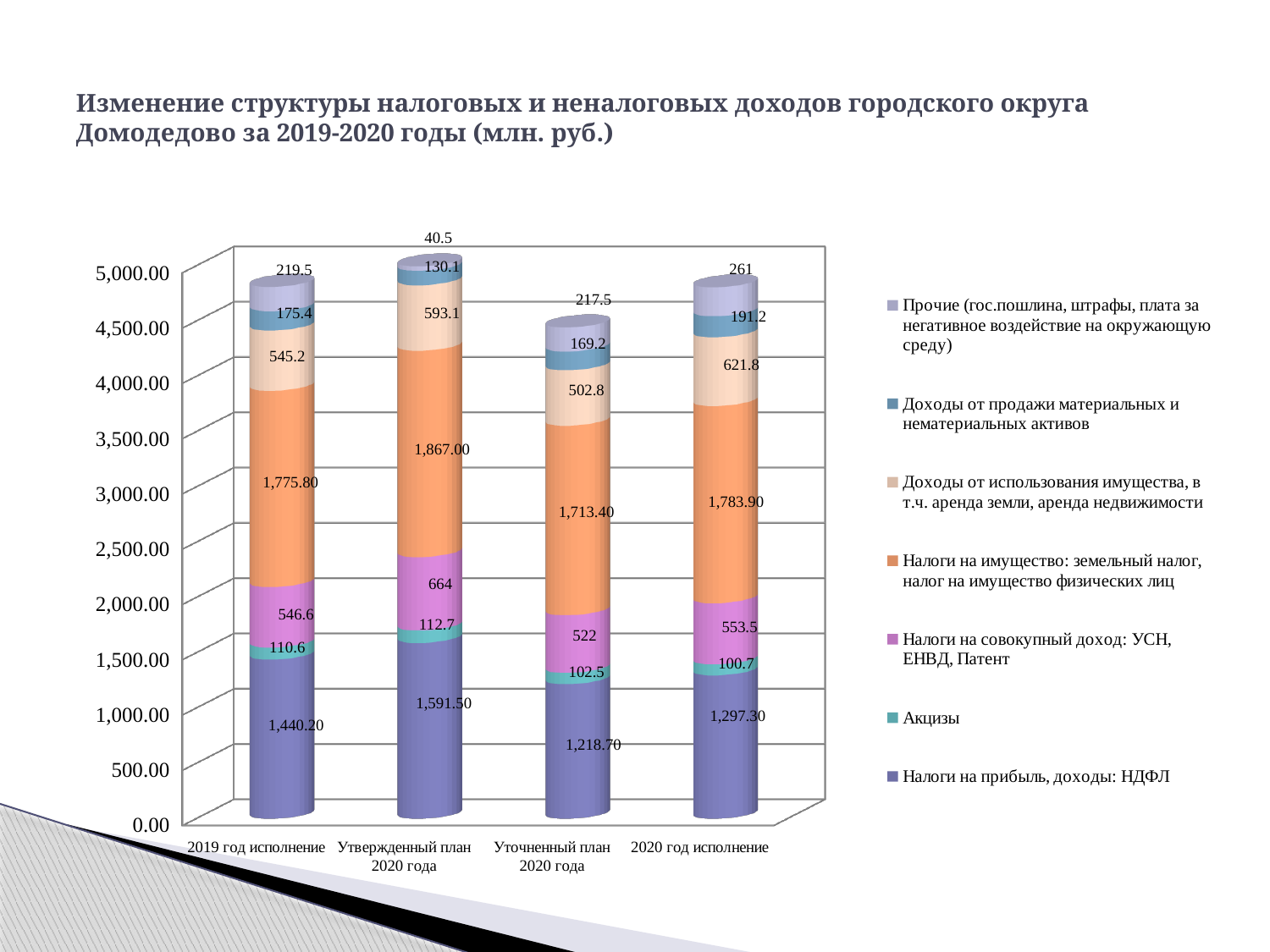
How many categories are shown on the x axis? 4 What is the value of Налоги на прибыль, доходы: НДФЛ for 2019 год исполнение? 1,440.20 How many series does the legend list? 7 What is the value of Доходы от продажи материальных и нематериальных активов for Уточненный план 2020 года? 169.2 What kind of chart is shown on the slide? Stacked bar chart What is the value of Акцизы for 2020 год исполнение? 100.7 Which category has the highest value for Налоги на прибыль, доходы: НДФЛ? Утвержденный план 2020 года What is the difference between Налоги на совокупный доход: УСН, ЕНВД, Патент for Утвержденный план 2020 года and Уточненный план 2020 года? 142 Which is larger for Доходы от использования имущества: Утвержденный план 2020 года or 2020 год исполнение? 2020 год исполнение What is the value of Налоги на имущество: земельный налог, налог на имущество физических лиц for Утвержденный план 2020 года? 1,867.00 What is the total of the stacked bar for 2019 год исполнение? 4,813.3 Which category has the lowest value for Прочие (гос.пошлина, штрафы, плата за негативное воздействие на окружающую среду)? Утвержденный план 2020 года